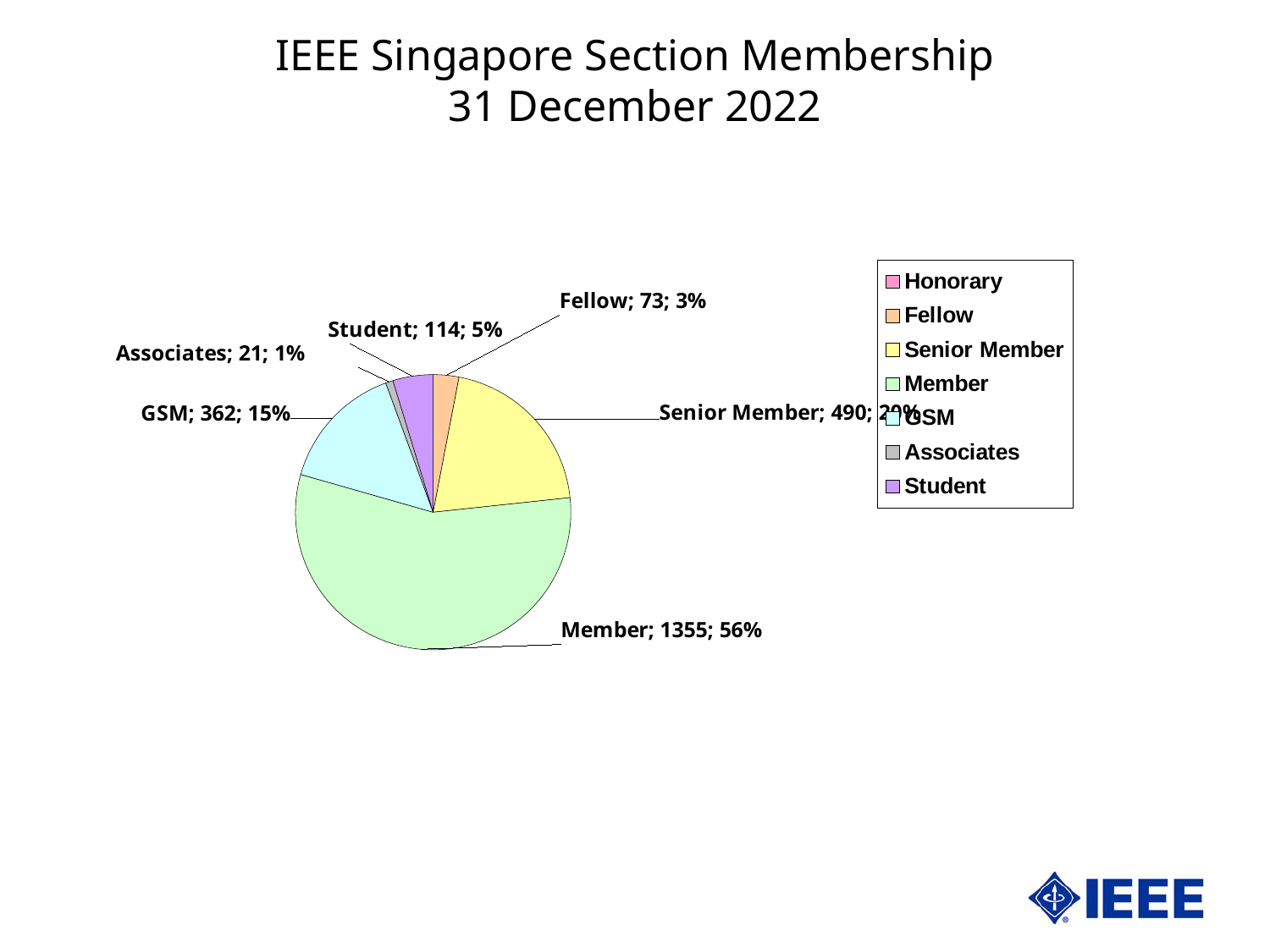
Which labelled category has the smallest slice of the pie? Associates What share of the pie does Student represent? 5% What is the value for GSM? 362 How many entries does the legend list? 7 What type of chart is shown on the slide? pie chart Which category has the largest slice of the pie? Member What is the value for Associates? 21 What is the difference between the Member value and the Senior Member value? 865 What share of the pie does Member represent? 56% How many members are in the Member category? 1355 Which is larger, GSM or Student? GSM What is the value for Fellow? 73